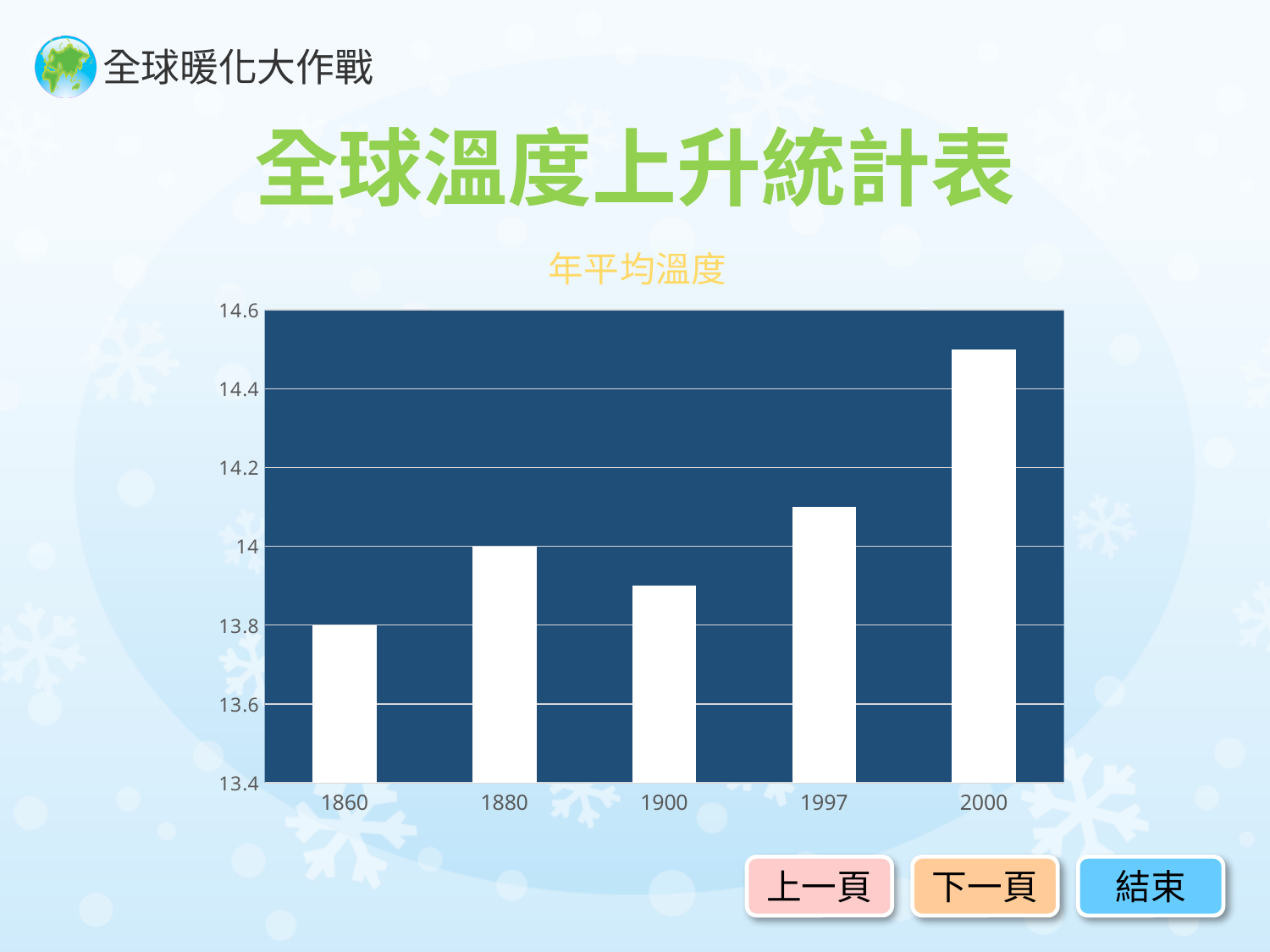
What is the value for 1880? 14 Which is larger, the value for 1997 or the value for 1900? 1997 From 1997 to 2000, does the value rise or fall? rise Is the value for 2000 greater or less than 14.4? greater Is the value for 1900 greater or less than 14? less Which year has the highest value? 2000 Which year has the lowest value? 1860 How many years are shown on the x axis of the chart? 5 Is the value for 1997 greater or less than 14? greater What is the chart's title? 年平均溫度 What kind of chart is shown on the slide? bar chart What is the value for 1860? 13.8